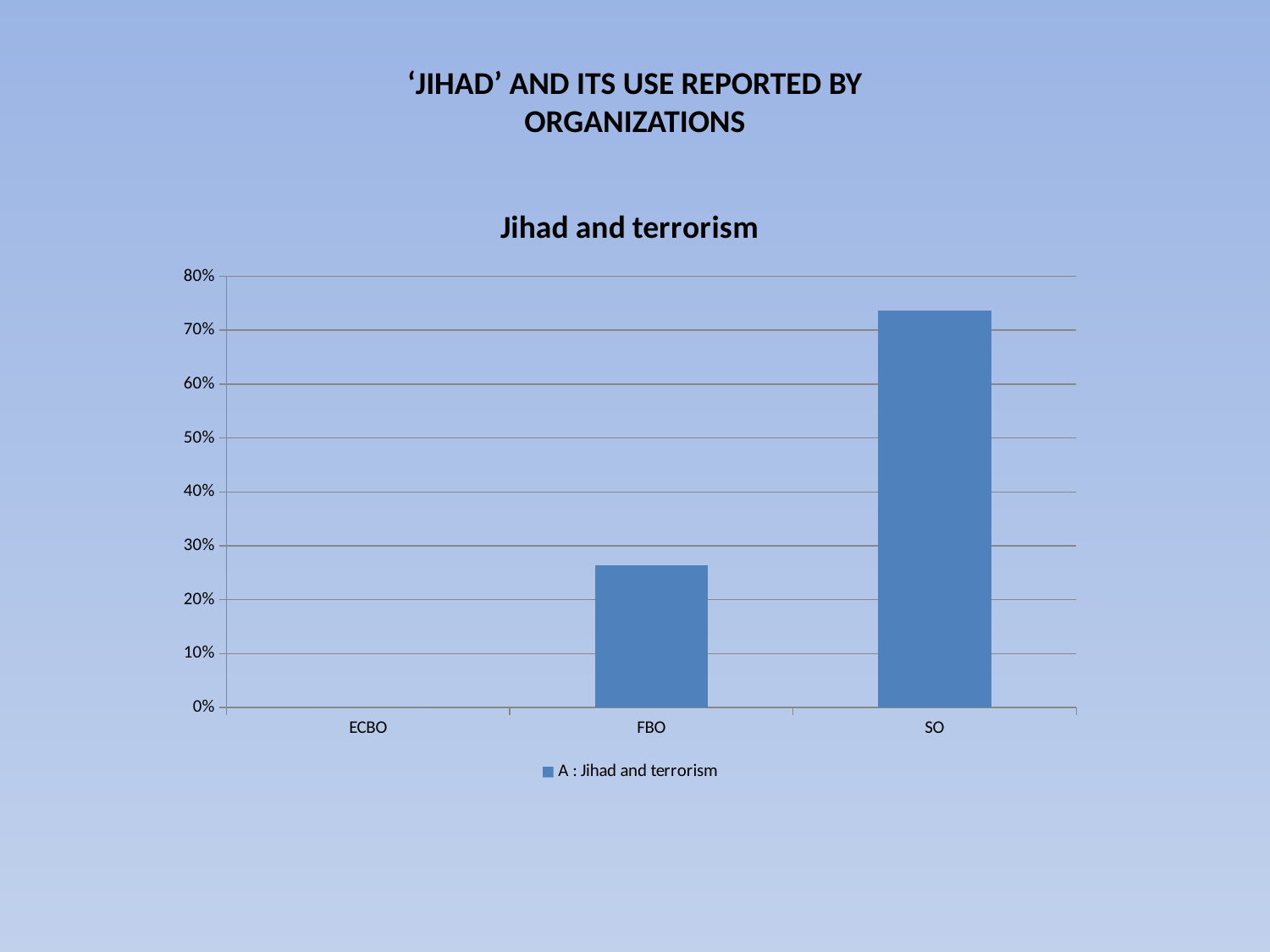
Which category has the lowest value in the chart? ECBO Which has a larger value, FBO or SO? SO Is the value for FBO greater or less than 20%? greater How many categories are shown on the x axis of the chart? 3 What is the title of the chart? Jihad and terrorism Which category has the highest value in the chart? SO Is the value for SO greater or less than 80%? less What kind of chart is shown on the slide? bar chart Is the value for FBO greater or less than 30%? less What is the name of the series listed in the legend? A : Jihad and terrorism How many series does the chart's legend list? 1